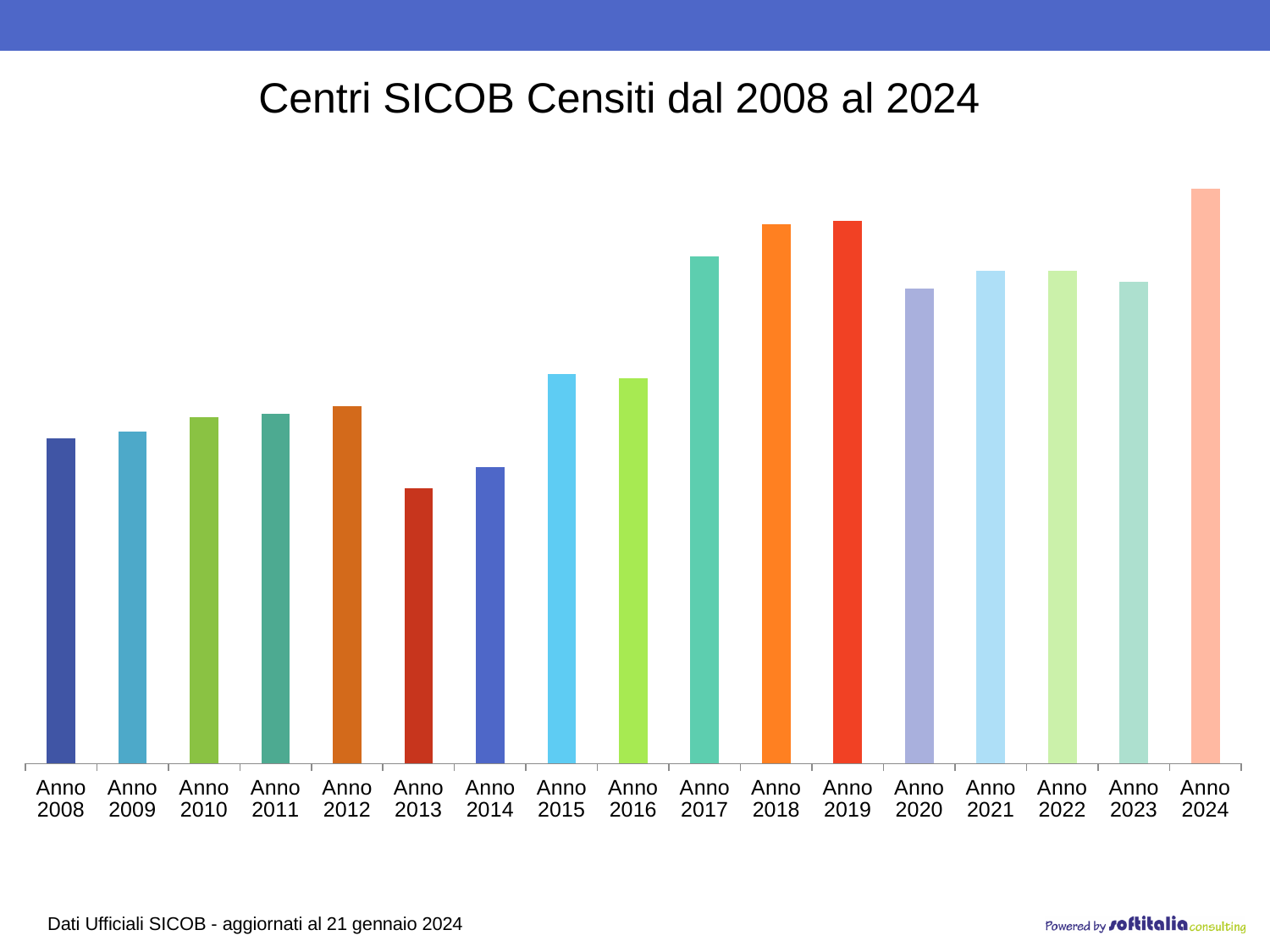
Which year has the lowest bar? Anno 2013 Which is larger, the value for Anno 2018 or Anno 2020? Anno 2018 What source note is printed at the bottom left of the slide? Dati Ufficiali SICOB - aggiornati al 21 gennaio 2024 From Anno 2019 to Anno 2020, does the value rise or fall? fall Which is larger, the value for Anno 2016 or Anno 2017? Anno 2017 Which year has the highest bar? Anno 2024 How many years (categories) are plotted on the x axis? 17 Which is larger, the value for Anno 2008 or Anno 2010? Anno 2010 From Anno 2008 to Anno 2012, do the values rise or fall? rise What is the title of the chart? Centri SICOB Censiti dal 2008 al 2024 What kind of chart is shown on the slide? bar chart